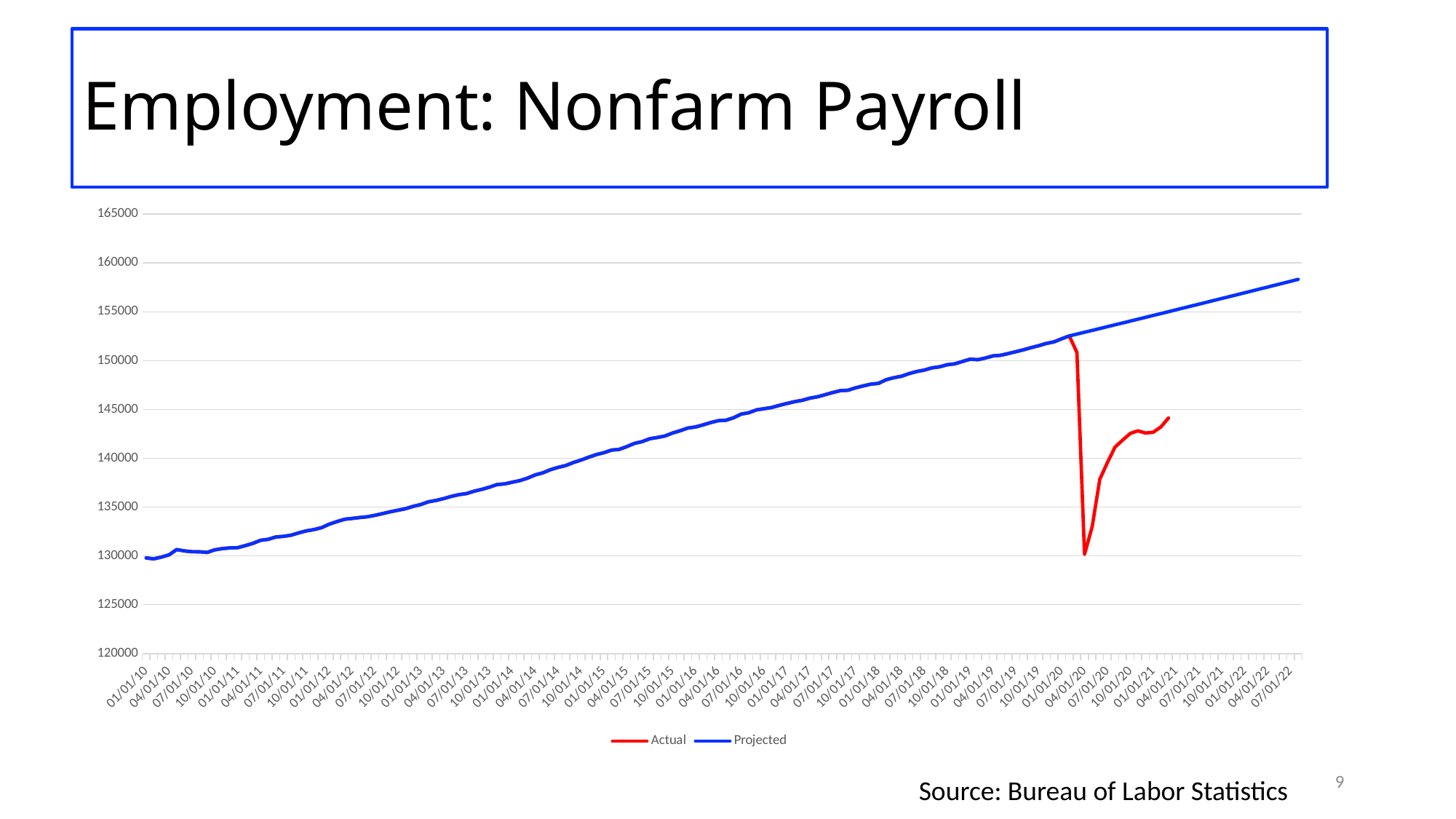
Is the Projected value at 01/01/14 greater or less than 140000? less Around 04/01/21, which series has the higher value, Actual or Projected? Projected Does the Projected series rise or fall from 01/01/10 to 07/01/22? rise Is the Projected value at 01/01/16 greater or less than 140000? greater Does the Actual series rise or fall between 01/01/20 and 04/01/20? fall What are the two series named in the legend? Actual and Projected What kind of chart is shown on the slide? line chart How many series does the legend list? 2 Is the Projected value at 07/01/22 greater or less than 155000? greater Which colour is used for the Projected series? blue